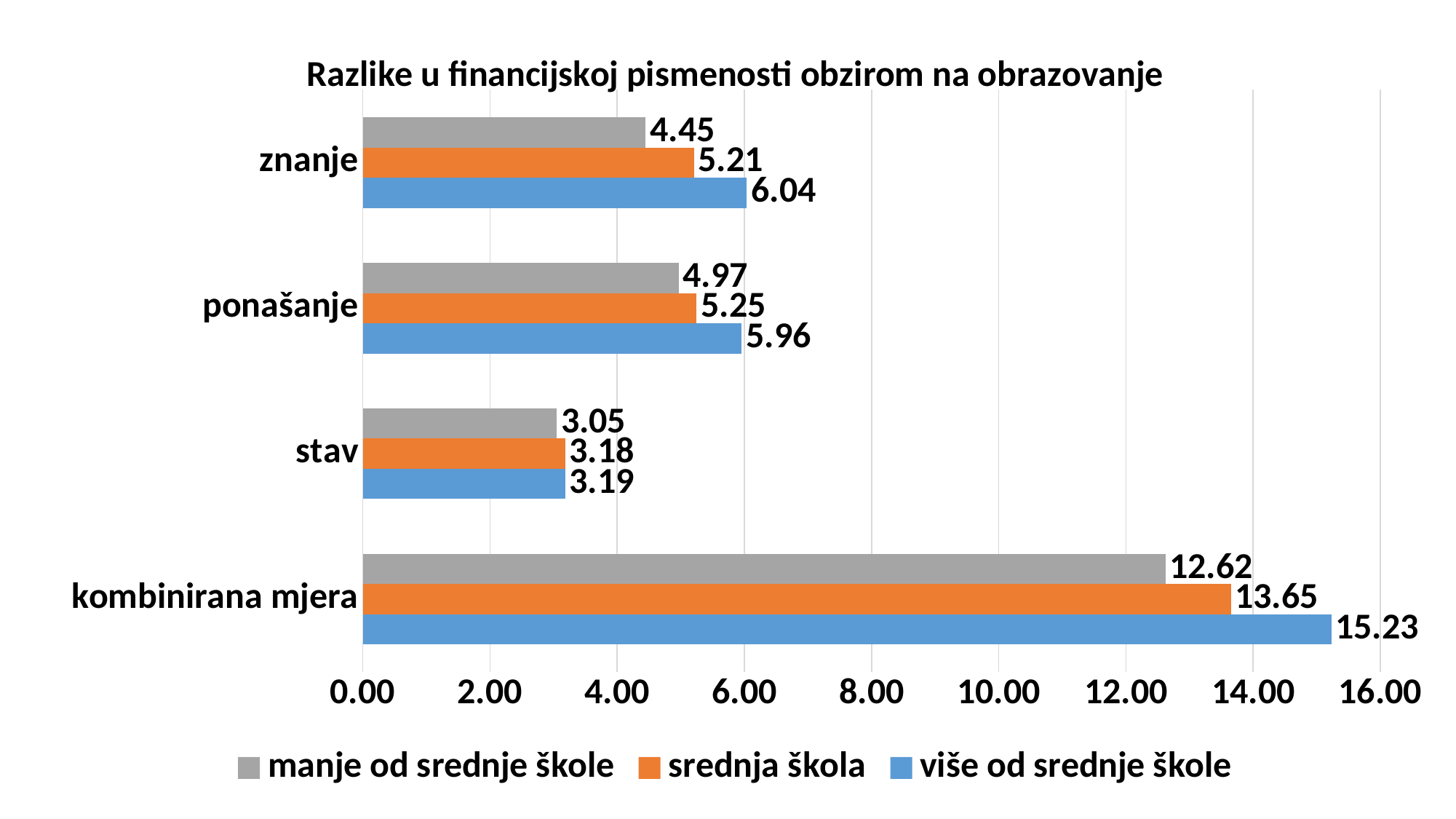
How many series does the legend list? 3 How many categories are shown on the chart? 4 What kind of chart is shown on the slide? bar chart Which category has the lowest value for 'manje od srednje škole'? stav Is the value for 'srednja škola' in 'kombinirana mjera' greater or less than 12.00? greater What is the value for 'srednja škola' in the 'ponašanje' category? 5.25 What is the title of the chart? Razlike u financijskoj pismenosti obzirom na obrazovanje What is the difference between 'više od srednje škole' and 'manje od srednje škole' in the 'kombinirana mjera' category? 2.61 What is the value for 'manje od srednje škole' in the 'kombinirana mjera' category? 12.62 Which is larger in the 'znanje' category: 'srednja škola' or 'manje od srednje škole'? srednja škola What is the value for 'više od srednje škole' in the 'znanje' category? 6.04 Which category has the highest value for 'više od srednje škole'? kombinirana mjera